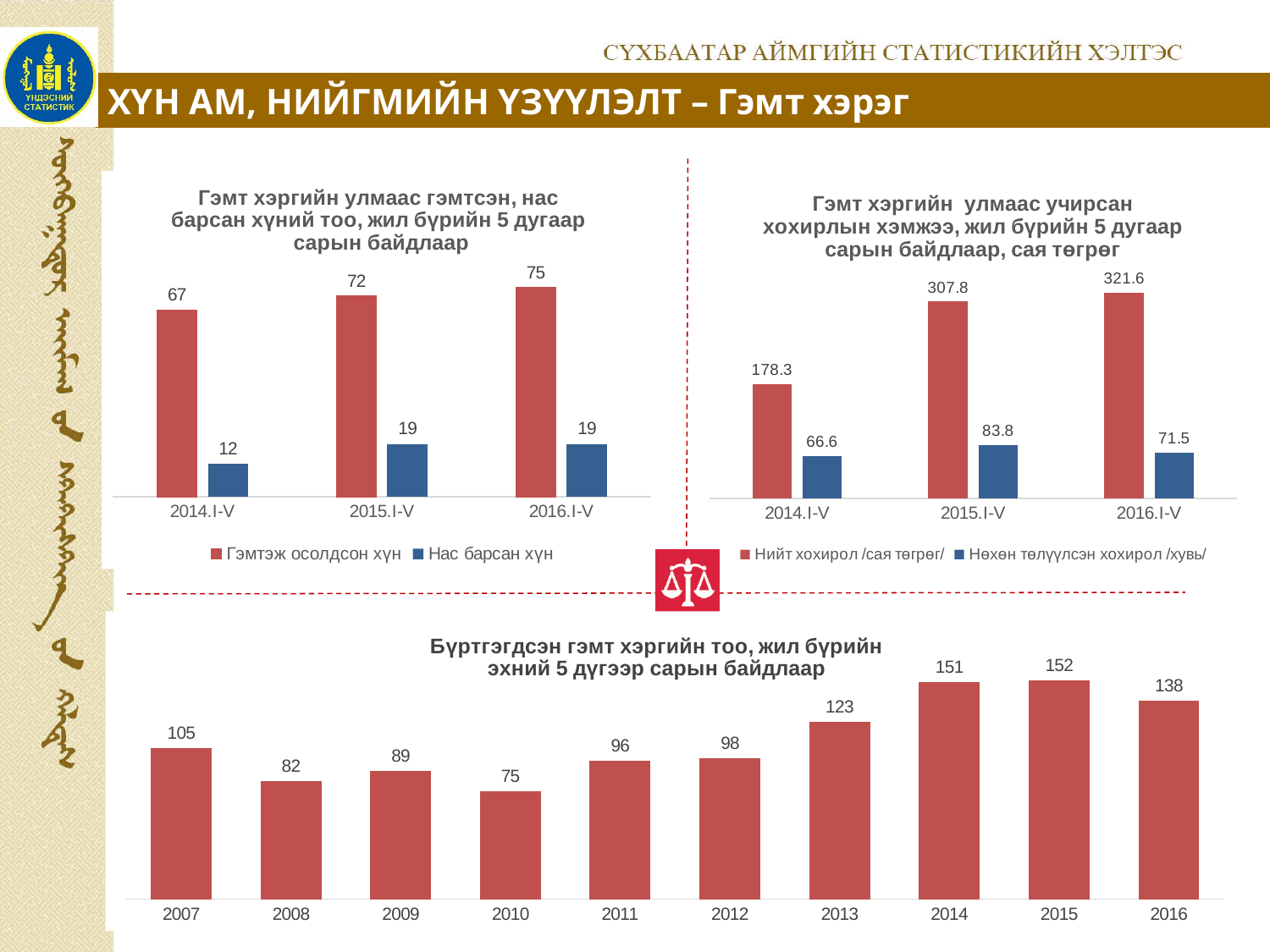
In the top-right chart, what is the difference between the red bar values for 2015.I-V and 2014.I-V? 129.5 In the top-left chart, what is the value of the red bar (Гэмтэж осолдсон хүн) for 2015.I-V? 72 In the bottom chart, which year has the lowest value? 2010 In the bottom chart, what is the difference between the values for 2015 and 2016? 14 In the top-right chart, what is the value of the red bar (Нийт хохирол) for 2016.I-V? 321.6 In the bottom chart, how many years are shown on the x axis? 10 In the bottom chart, which year has the highest value? 2015 What type of chart is the bottom chart? Bar chart In the top-left chart, what is the value of the blue bar (Нас барсан хүн) for 2014.I-V? 12 In the top-left chart, how many series does the legend list? 2 In the bottom chart, what is the value for 2014? 151 In the top-right chart, which is larger: the blue bar for 2015.I-V or the blue bar for 2016.I-V? 2015.I-V